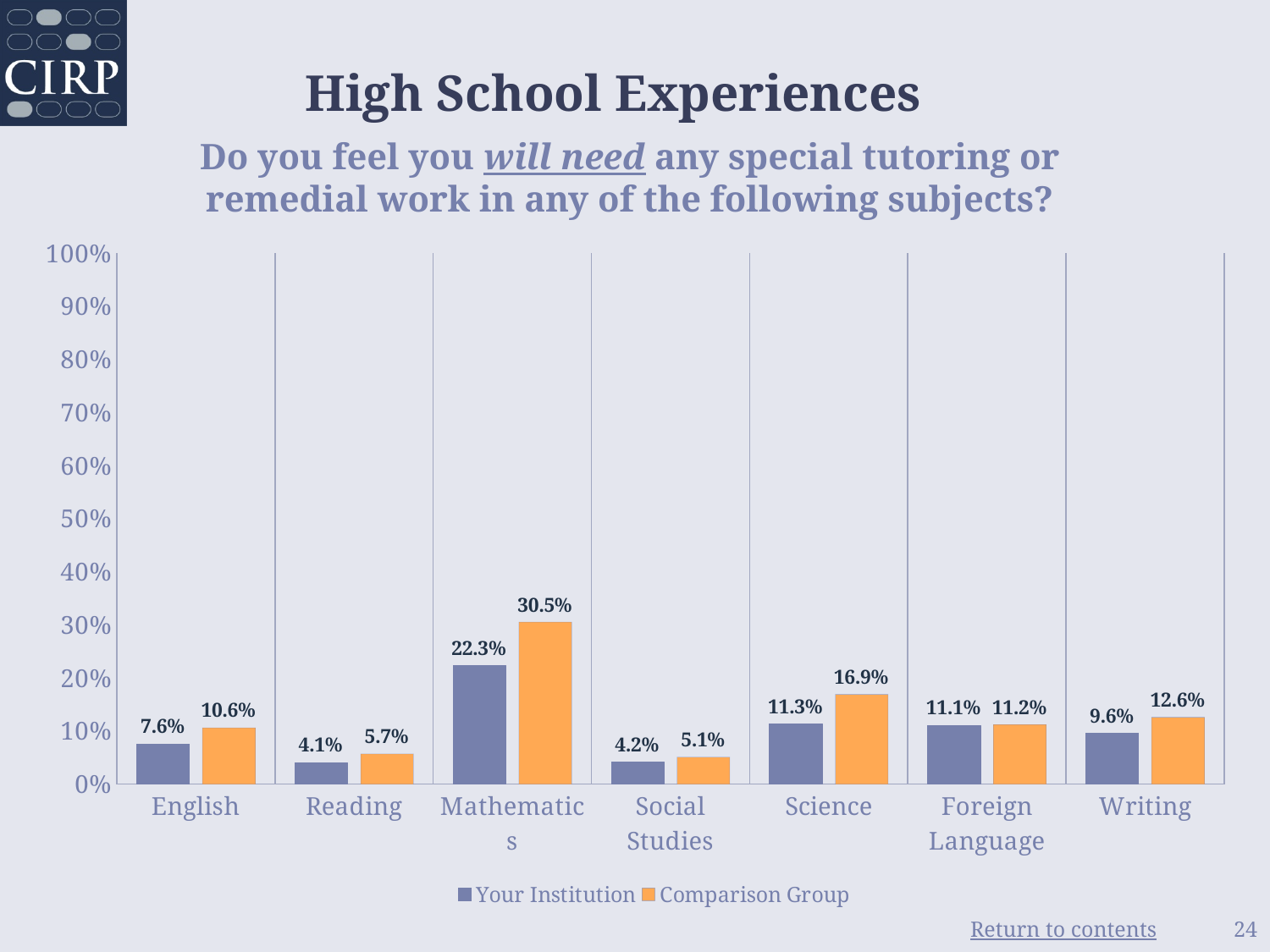
Which subject has the highest value for Comparison Group? Mathematics How many subjects are shown on the x axis? 7 Which is larger for Writing: Your Institution or Comparison Group? Comparison Group What kind of chart is shown on the slide? Bar chart Is the value for Comparison Group for Mathematics greater or less than 30%? greater How many series does the legend list? 2 Which subject has the lowest value for Your Institution? Reading What is the difference between Comparison Group and Your Institution for Mathematics? 8.2% What is the value for Comparison Group for Science? 16.9% What is the difference between Comparison Group and Your Institution for English? 3.0% What is the value for Your Institution for Mathematics? 22.3% What is the value for Your Institution for Reading? 4.1%